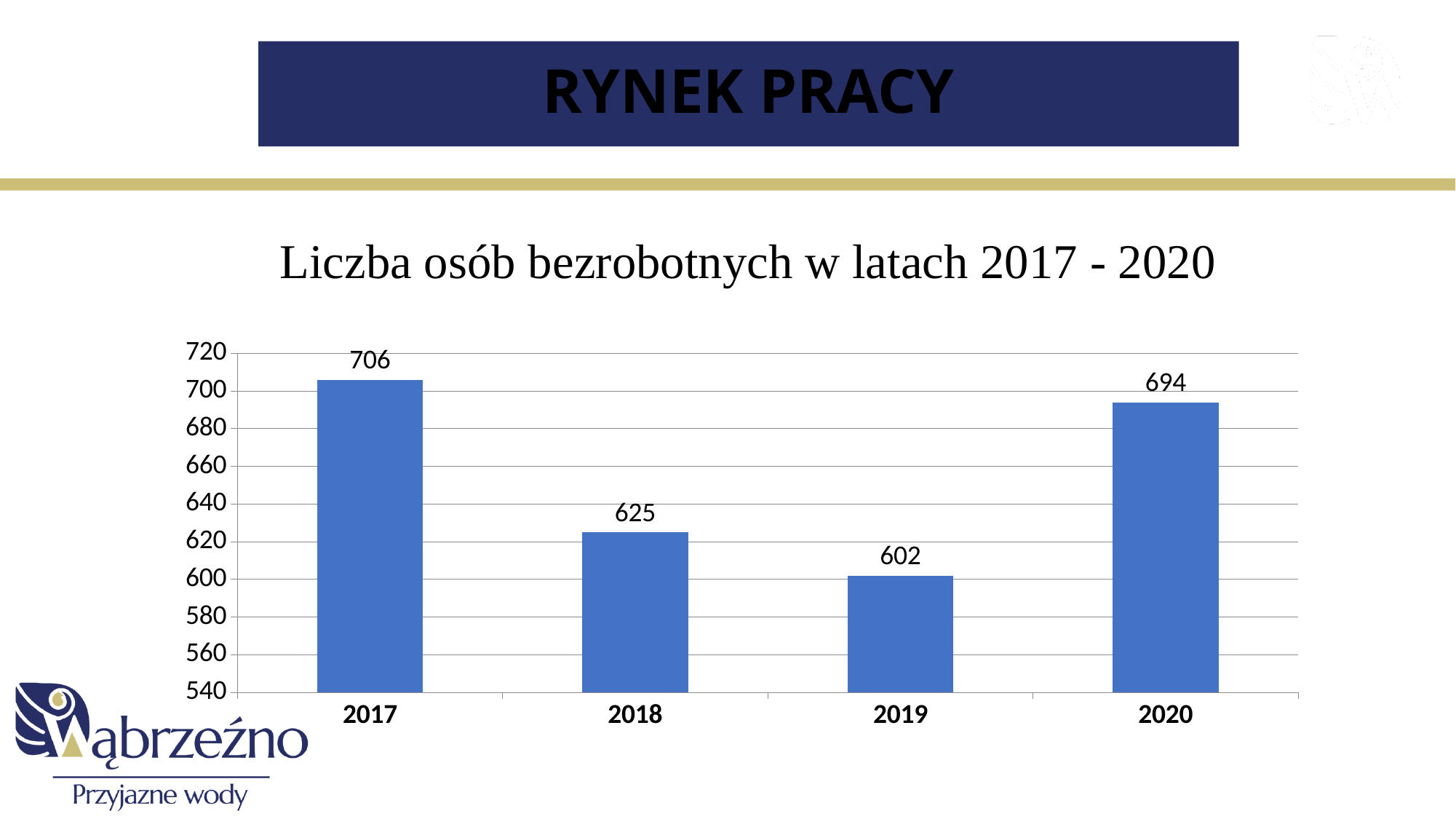
Which year has the highest number of unemployed persons? 2017 By how much did the value increase from 2019 to 2020? 92 What is the number of unemployed persons shown for 2017? 706 What kind of chart is shown on the slide? bar chart What is the difference between the values for 2017 and 2019? 104 What is the title of the chart? Liczba osób bezrobotnych w latach 2017 - 2020 How many years are shown on the chart? 4 What value is shown for 2020? 694 What value is shown for 2019? 602 Is the value for 2018 greater or less than 640? less Which is larger, the value for 2018 or the value for 2020? 2020 Which year has the lowest number of unemployed persons? 2019